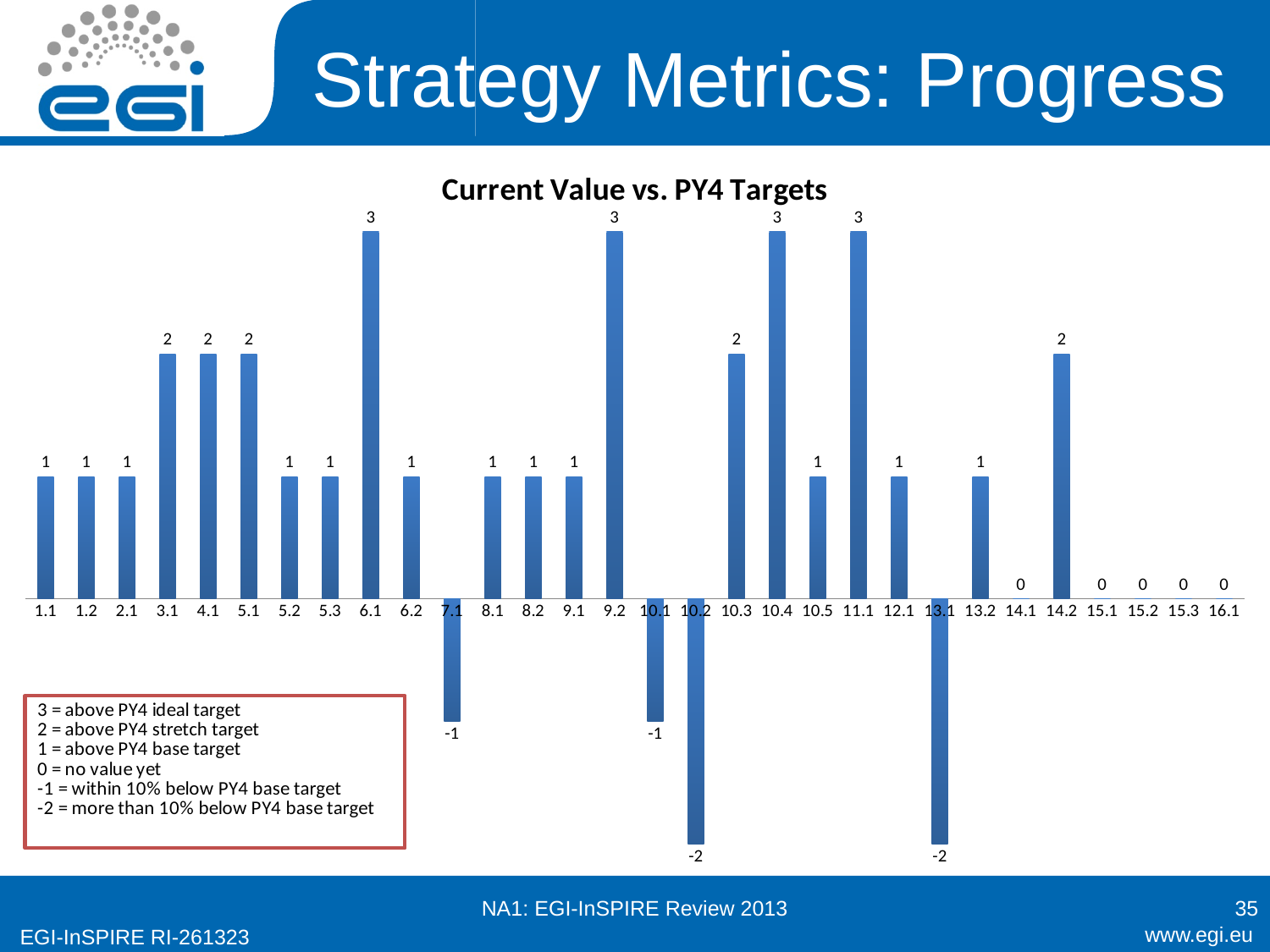
Which has the larger value, 10.3 or 10.5? 10.3 What is the difference between the values for 3.1 and 5.2? 1 What is the value for 6.1 in the Current Value vs. PY4 Targets chart? 3 What is the value for 14.2 in the chart? 2 What is the value for 16.1 in the chart? 0 What is the value for 10.2 in the chart? -2 Which has the larger value, 13.1 or 13.2? 13.2 What is the value for 7.1 in the chart? -1 What kind of chart is shown on the slide? Bar chart What is the title of the chart? Current Value vs. PY4 Targets How many categories are shown on the x axis of the chart? 30 What is the difference between the values for 9.2 and 10.1? 4